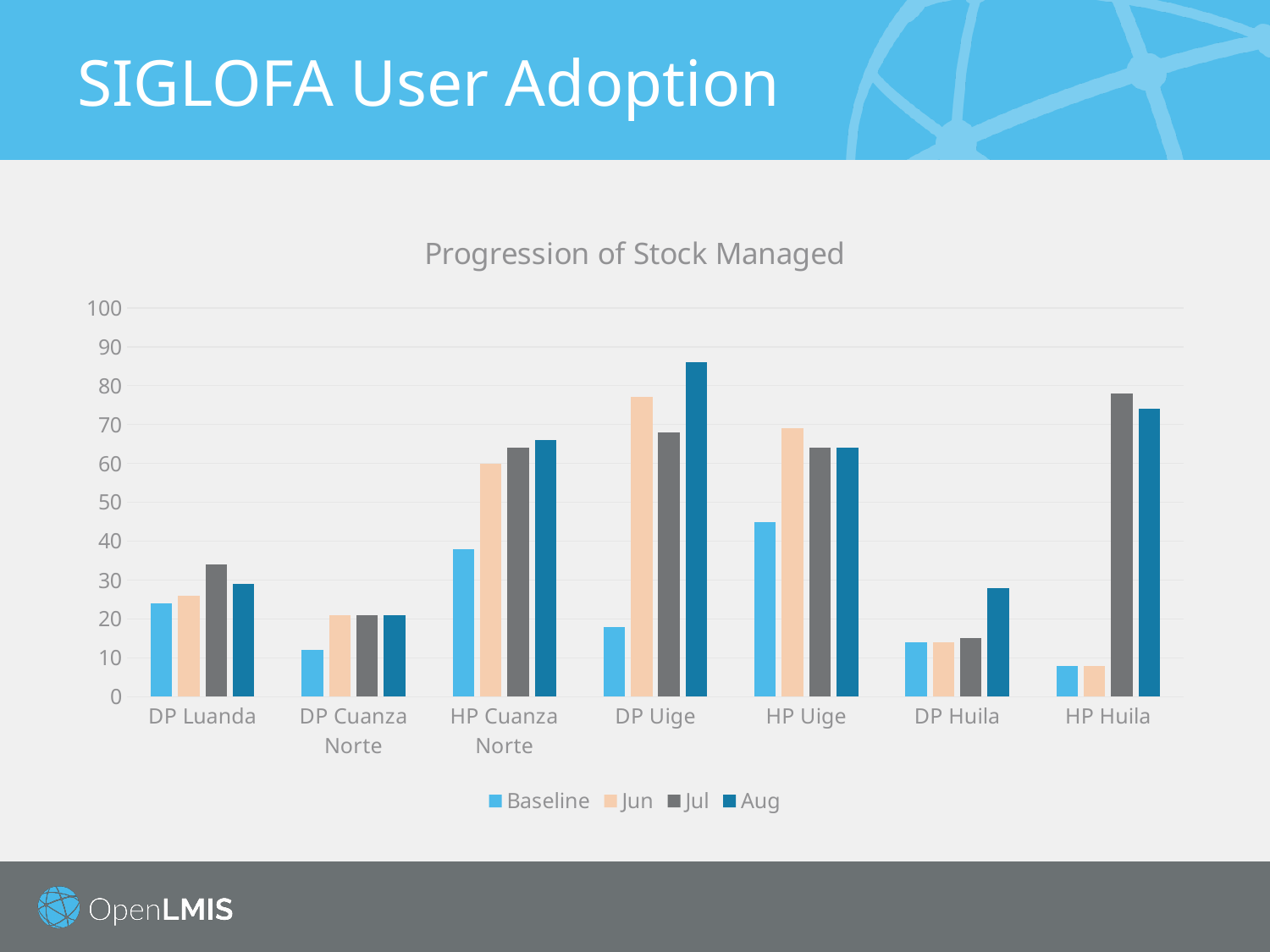
Which category has the highest Aug value? DP Uige How many categories are shown on the x axis? 7 Is the Aug value for DP Uige greater or less than 80? greater Which is larger, the Baseline value for HP Uige or the Baseline value for DP Uige? HP Uige How many series does the legend list? 4 What kind of chart is shown on the slide? Bar chart Which is larger, the Jun value for DP Uige or the Jun value for HP Uige? DP Uige Which category has the lowest Baseline value? HP Huila Is the Baseline value for HP Cuanza Norte greater or less than 30? greater What is the title of the chart? Progression of Stock Managed Is the Jul value for HP Huila greater or less than 70? greater For HP Cuanza Norte, do the values rise or fall from Baseline through Aug? rise